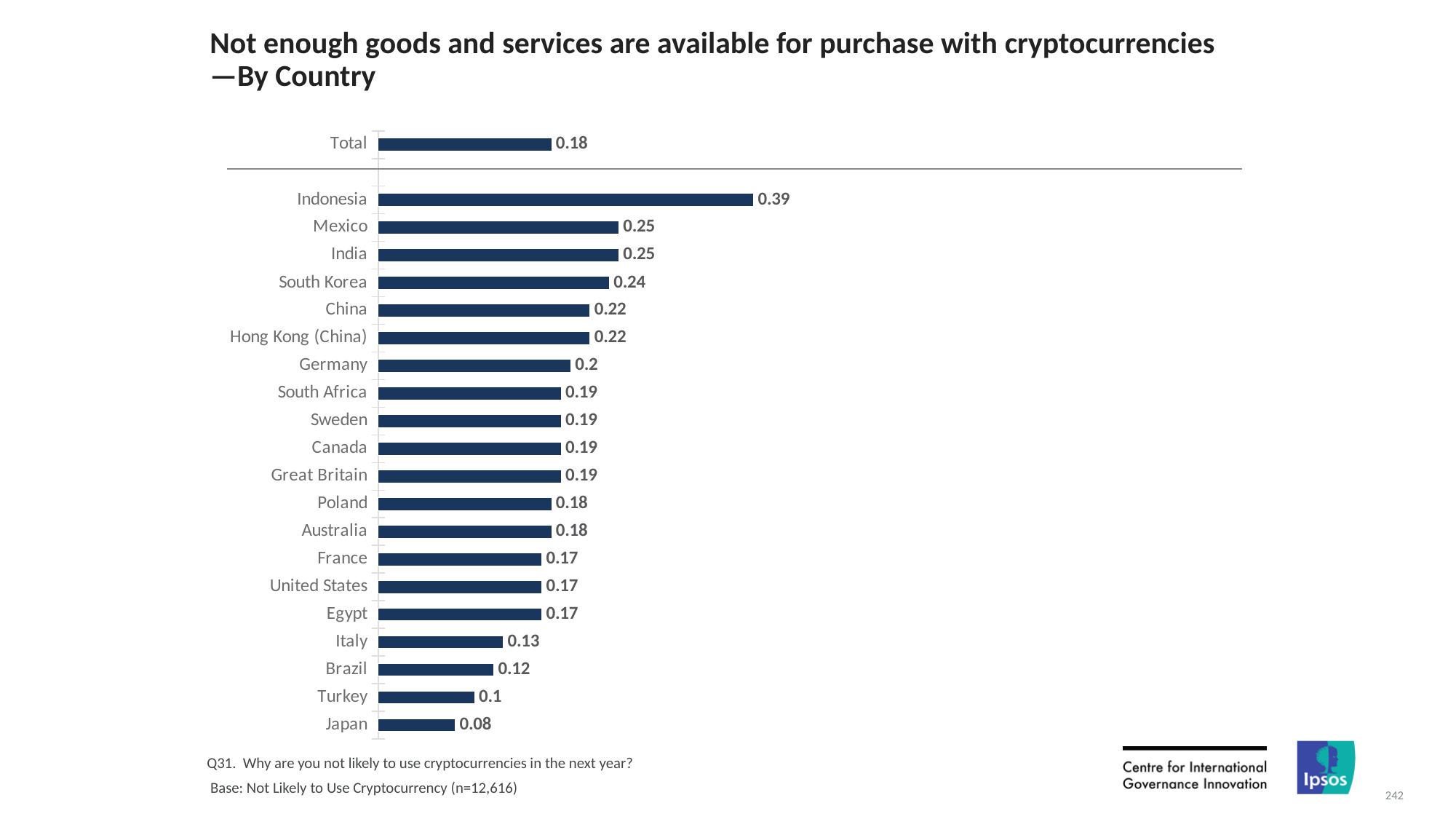
How many countries are shown in the chart, excluding Total? 20 What is the difference between the values for Indonesia and Japan? 0.31 Which has a larger value, South Korea or Italy? South Korea What is the title of the chart? Not enough goods and services are available for purchase with cryptocurrencies—By Country What is the value for Japan? 0.08 What kind of chart is shown on the slide? Bar chart Which country has the lowest value? Japan What is the difference between the values for Mexico and Turkey? 0.15 What is the value for Indonesia? 0.39 Which country has the highest value? Indonesia What is the value for Germany? 0.2 What is the value for Total? 0.18